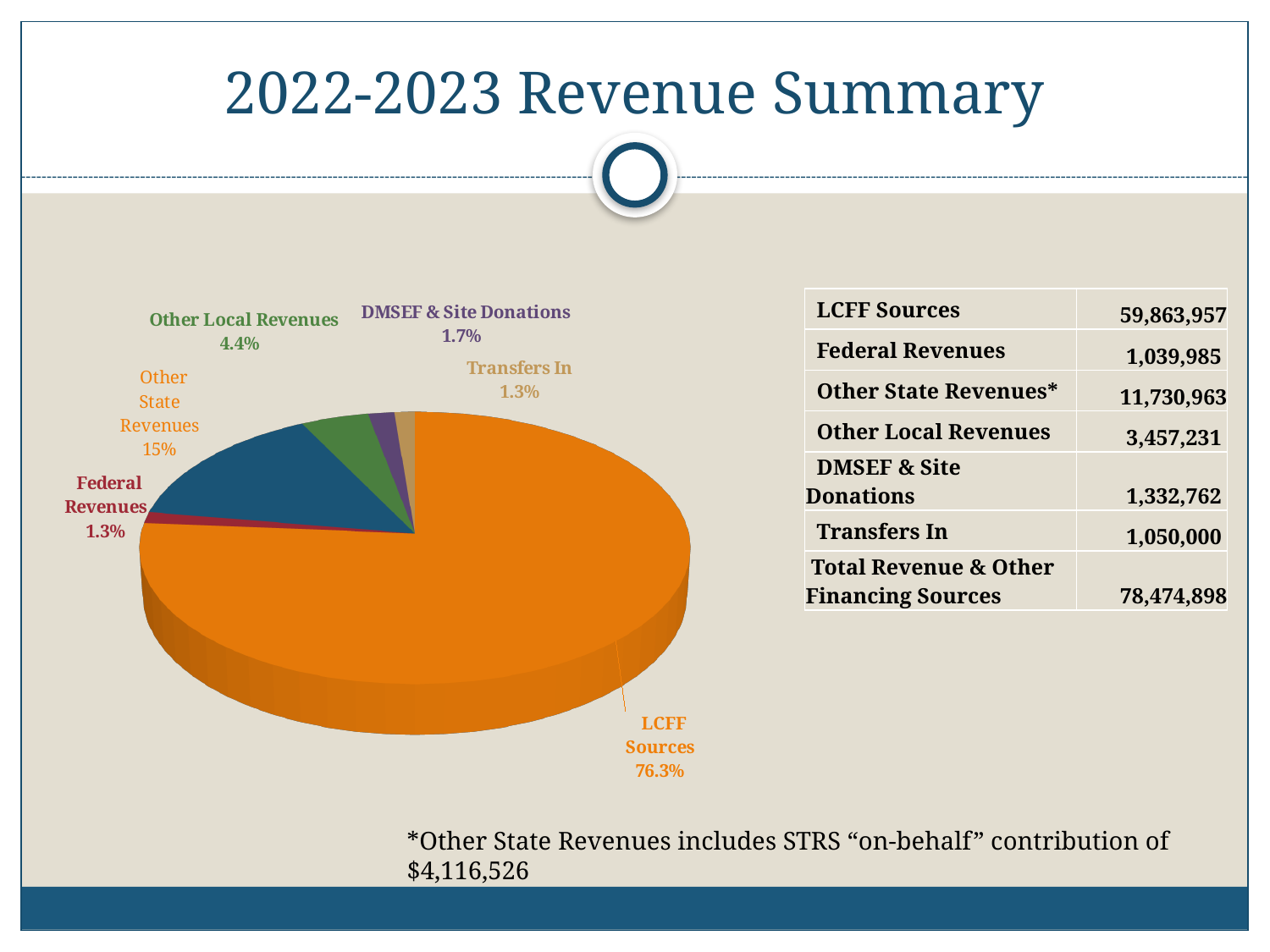
What is the title of the slide containing the pie chart? 2022-2023 Revenue Summary What share of the pie does Other State Revenues represent? 15% What share of the pie does LCFF Sources represent? 76.3% What is the difference in percentage points between the LCFF Sources share and the Other State Revenues share? 61.3 Which is larger, the share for Other Local Revenues or the share for DMSEF & Site Donations? Other Local Revenues What share of the pie does Other Local Revenues represent? 4.4% What colour is the LCFF Sources slice of the pie? orange Which slice of the pie is the largest? LCFF Sources How many slices does the pie chart have? 6 What kind of chart is shown on the slide? pie chart